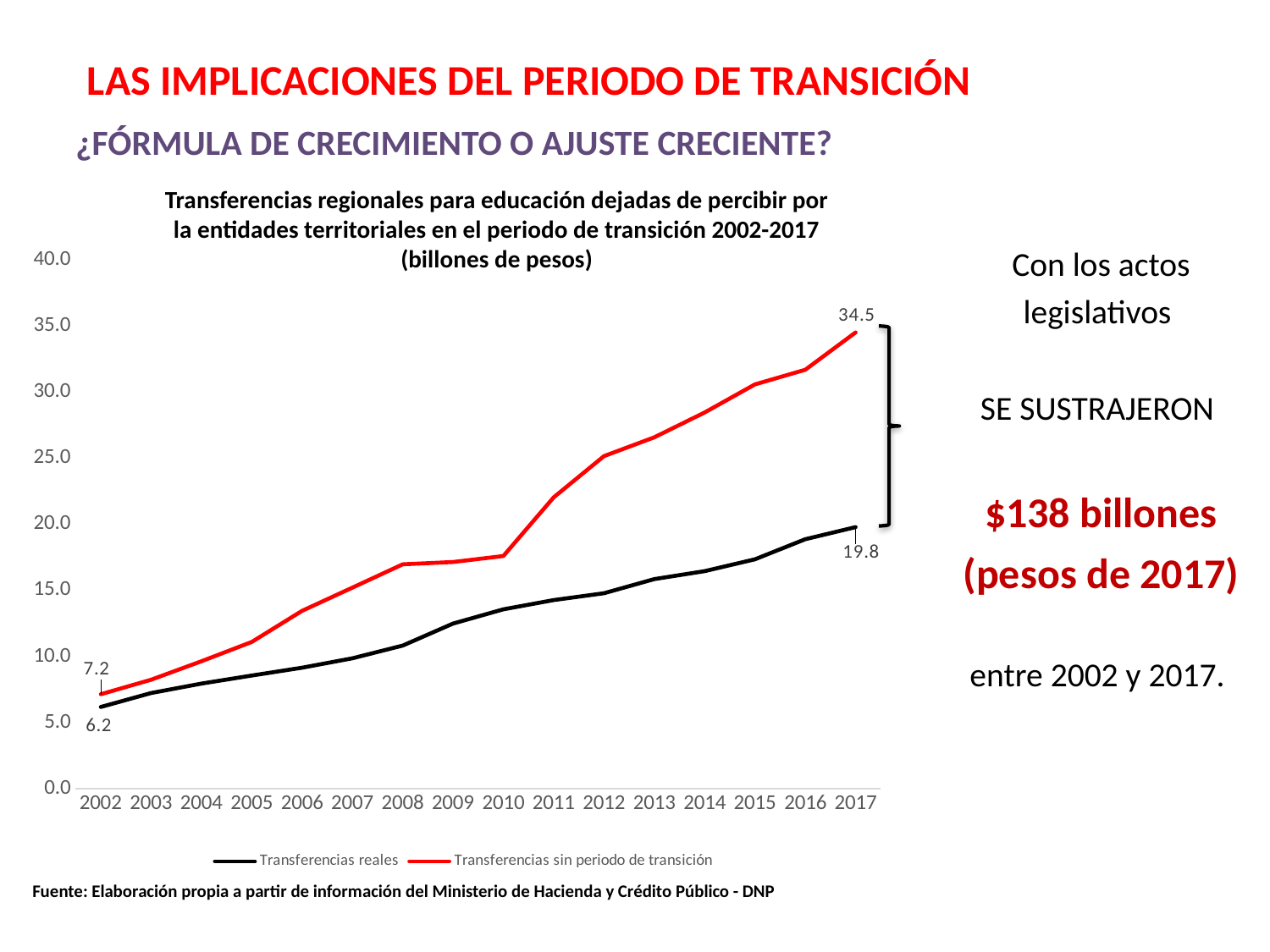
What type of chart is shown on the slide? Line chart Do the values of Transferencias reales rise or fall from 2002 to 2017? Rise Is the value for Transferencias sin periodo de transición in 2012 greater or less than 20.0? greater What is the difference between Transferencias sin periodo de transición and Transferencias reales in 2017? 14.7 What is the value of Transferencias reales in 2017? 19.8 What is the value of Transferencias sin periodo de transición in 2017? 34.5 In 2017, which series has the larger value: Transferencias reales or Transferencias sin periodo de transición? Transferencias sin periodo de transición Which colour is used for the Transferencias sin periodo de transición line? Red What is the value of Transferencias sin periodo de transición in 2002? 7.2 How many years are shown on the x axis of the chart? 16 How many series does the chart legend list? 2 What is the value of Transferencias reales in 2002? 6.2